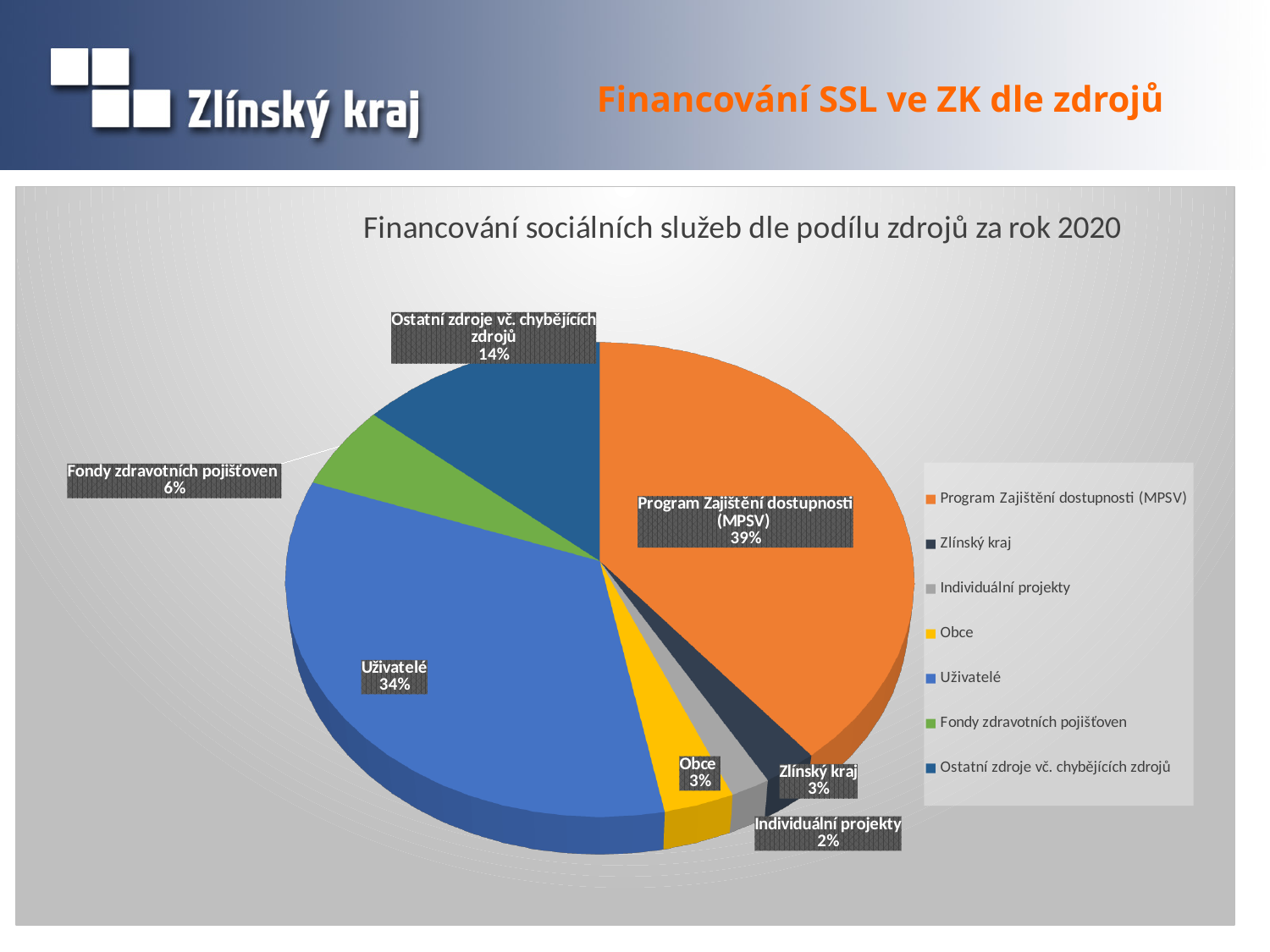
What is the difference in percentage points between Program Zajištění dostupnosti (MPSV) and Uživatelé? 5 Which category has the largest share of the pie? Program Zajištění dostupnosti (MPSV) What share of the pie does Uživatelé represent? 34% What kind of chart is shown on the slide? Pie chart What is the value shown for Ostatní zdroje vč. chybějících zdrojů? 14% What is the value shown for Fondy zdravotních pojišťoven? 6% What is the title of the chart? Financování sociálních služeb dle podílu zdrojů za rok 2020 What is the value shown for Individuální projekty? 2% Which category has the smallest share of the pie? Individuální projekty What share of the pie does Program Zajištění dostupnosti (MPSV) represent? 39% Which is larger, the share for Ostatní zdroje vč. chybějících zdrojů or the share for Fondy zdravotních pojišťoven? Ostatní zdroje vč. chybějících zdrojů How many categories does the pie chart show? 7